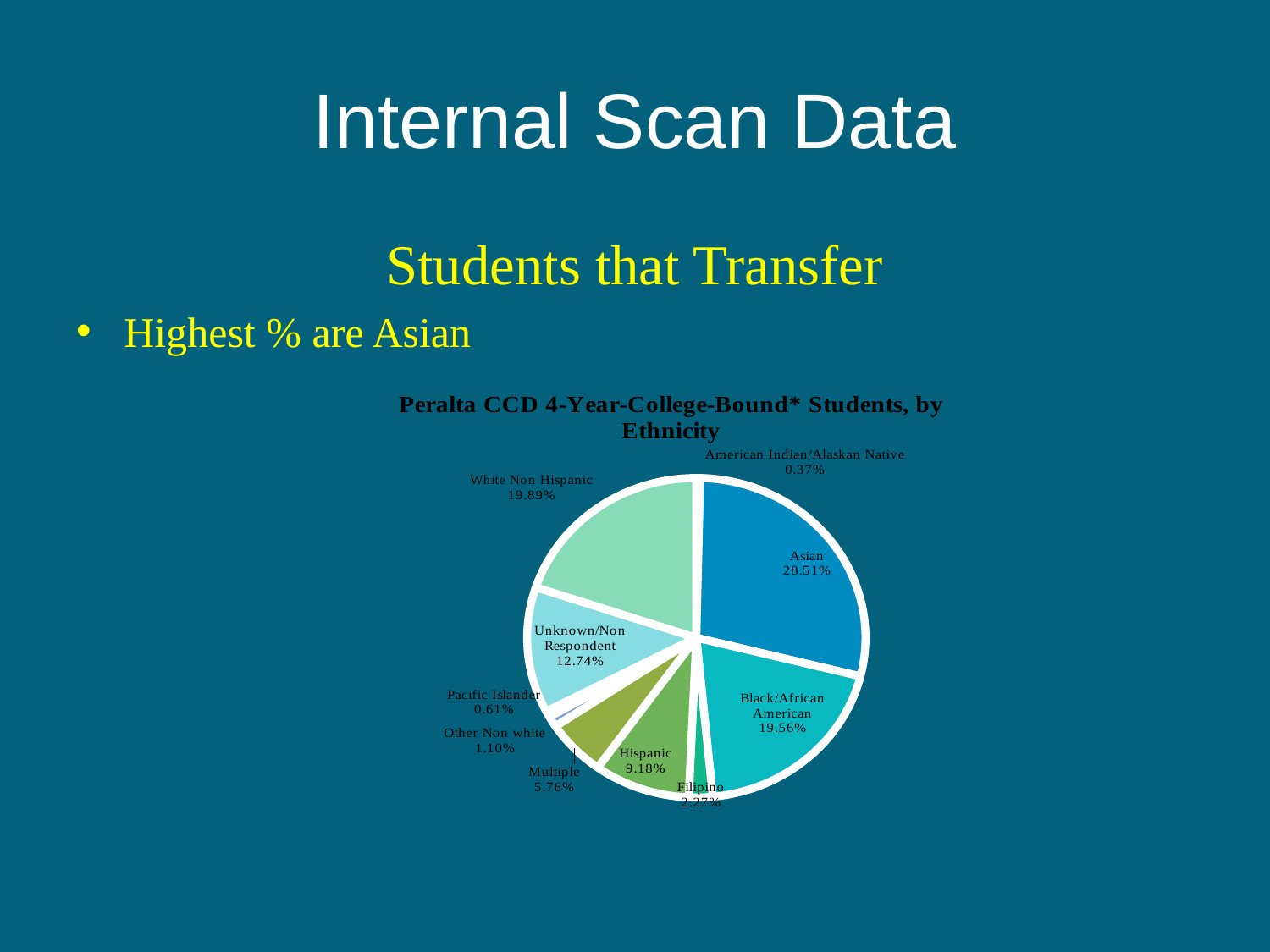
What percentage is shown for Unknown/Non Respondent? 12.74% Which ethnicity has the largest slice of the pie? Asian What percentage is shown for Pacific Islander? 0.61% Which ethnicity has the smallest slice of the pie? American Indian/Alaskan Native What percentage of the pie is the Asian slice? 28.51% How many slices does the pie chart have? 10 What is the difference in percentage points between the Asian slice and the White Non Hispanic slice? 8.62 Which is larger, the Multiple slice or the Filipino slice? Multiple What kind of chart is shown on the slide? Pie chart What is the title of the chart? Peralta CCD 4-Year-College-Bound* Students, by Ethnicity What percentage is shown for Hispanic? 9.18% What percentage is shown for Black/African American? 19.56%